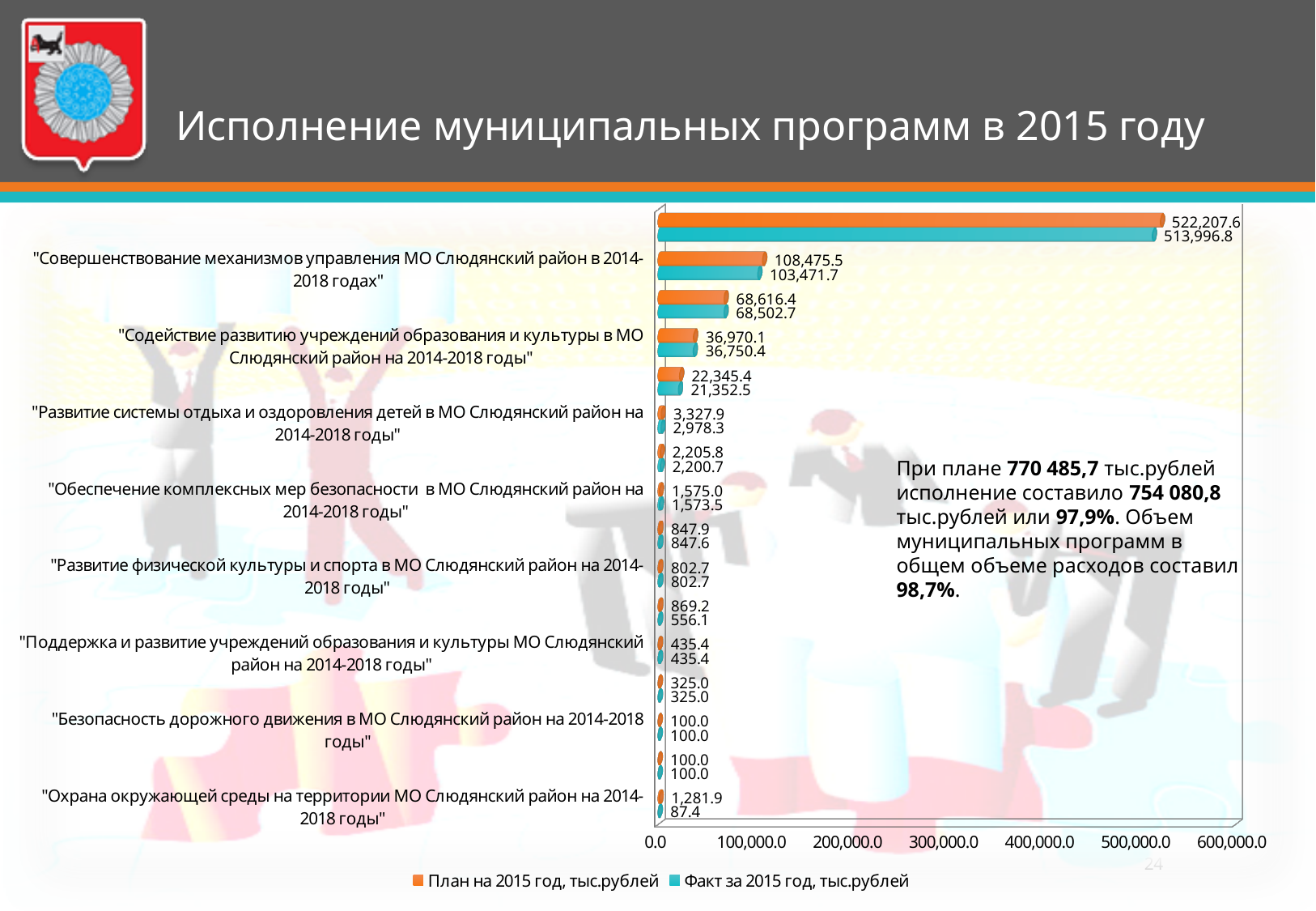
What is the largest tick value shown on the chart's horizontal axis? 600,000.0 What is the 'Факт за 2015 год' value in the pair of bars where the plan value is 869.2? 556.1 What is the 'Факт за 2015 год' value for the topmost pair of bars in the chart? 513,996.8 For the topmost pair of bars, what is the difference between the plan value (522,207.6) and the fact value (513,996.8)? 8,210.8 For the bottommost pair of bars, which is larger: the plan value or the fact value? Plan (1,281.9) How many pairs of bars (categories) are plotted in the chart? 16 What is the highest value of the 'План на 2015 год' series in the chart? 522,207.6 What type of chart is shown on the slide? Horizontal bar chart What is the 'План на 2015 год' value for the bottommost pair of bars in the chart? 1,281.9 How many series does the chart legend list? 2 What is the 'Факт за 2015 год' value for the bottommost pair of bars in the chart? 87.4 What are the two series named in the chart legend? План на 2015 год, тыс.рублей; Факт за 2015 год, тыс.рублей